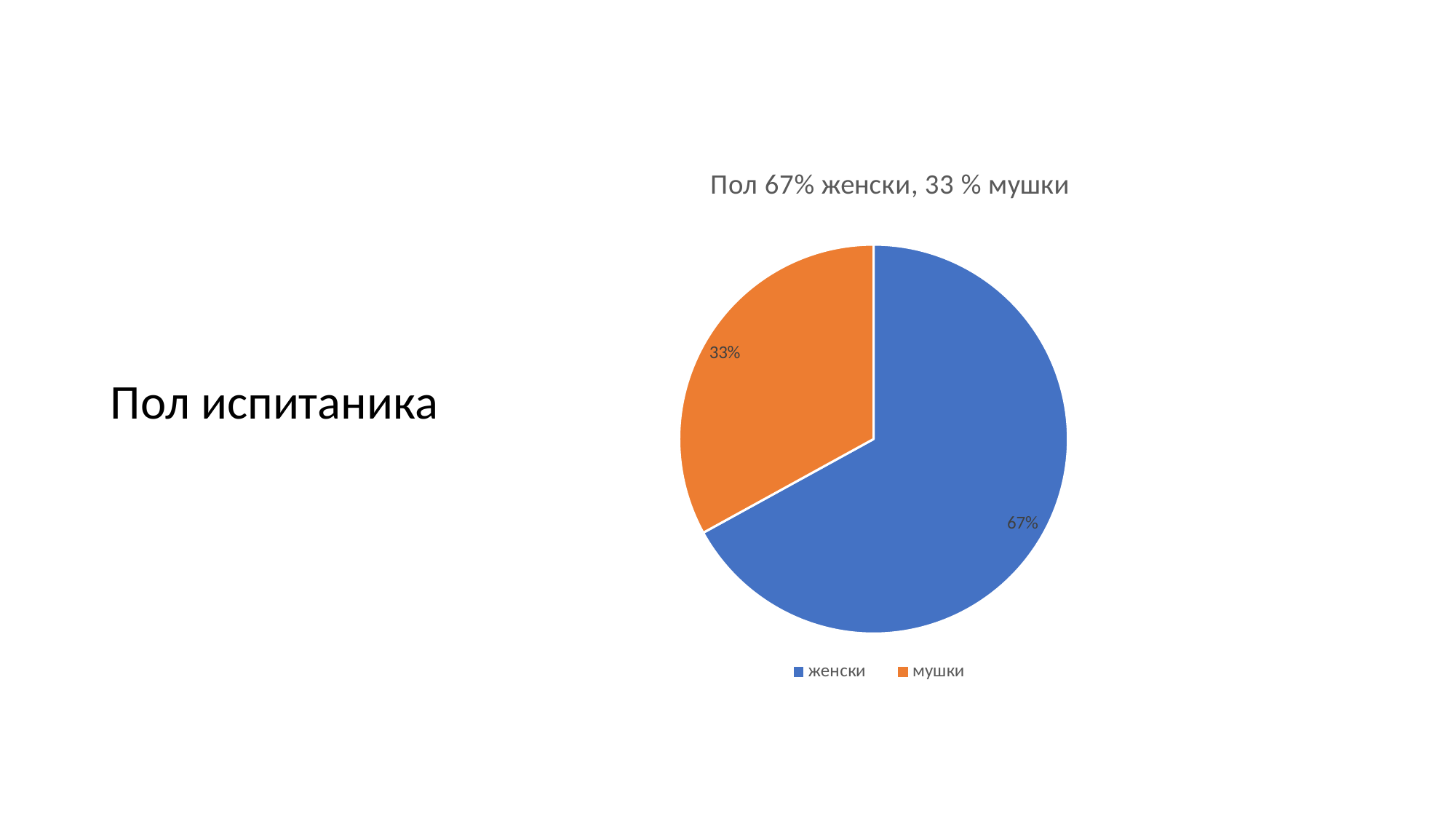
What kind of chart is shown on the slide? pie chart Which is larger, the share for женски or the share for мушки? женски What is the title of the chart? Пол 67% женски, 33 % мушки Which category has the largest share of the pie? женски How many entries does the legend list? 2 What is the value for мушки? 33% Which category has the smallest share of the pie? мушки What colour is the slice for мушки? orange How many slices does the pie chart have? 2 What is the difference between the share for женски and the share for мушки? 34% What is the value for женски? 67%